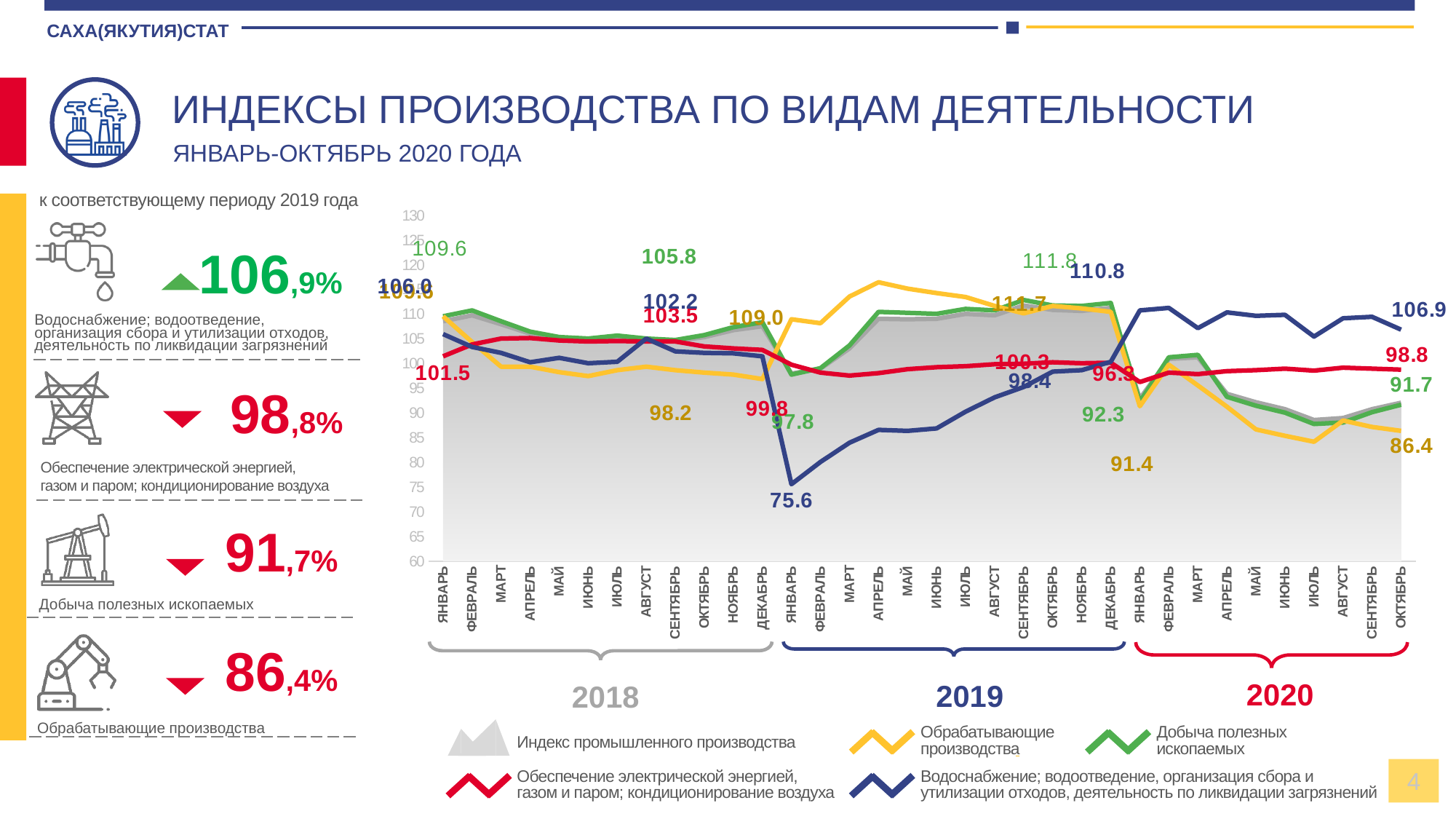
What is the value of the Обрабатывающие производства series for ОКТЯБРЬ 2020? 86.4 What is the difference between the Водоснабжение series and the Обрабатывающие производства series in ОКТЯБРЬ 2020? 20.5 Which series has the highest value in ОКТЯБРЬ 2020? Водоснабжение; водоотведение, организация сбора и утилизации отходов, деятельность по ликвидации загрязнений How many years are marked with brackets below the x axis? 3 What is the value of the Добыча полезных ископаемых series for ОКТЯБРЬ 2020? 91.7 Is the value of the Обрабатывающие производства series in АПРЕЛЬ 2019 greater or less than 110? greater What is the value of the Водоснабжение; водоотведение series for ОКТЯБРЬ 2020? 106.9 What kind of chart is shown on the slide? combination area and line chart In ОКТЯБРЬ 2020, which is larger: the Обеспечение электрической энергией series or the Добыча полезных ископаемых series? Обеспечение электрической энергией, газом и паром; кондиционирование воздуха What is the value of the Обеспечение электрической энергией series for ОКТЯБРЬ 2020? 98.8 How many series does the chart legend list? 5 What is the lowest value reached by the Водоснабжение; водоотведение series on the chart? 75.6